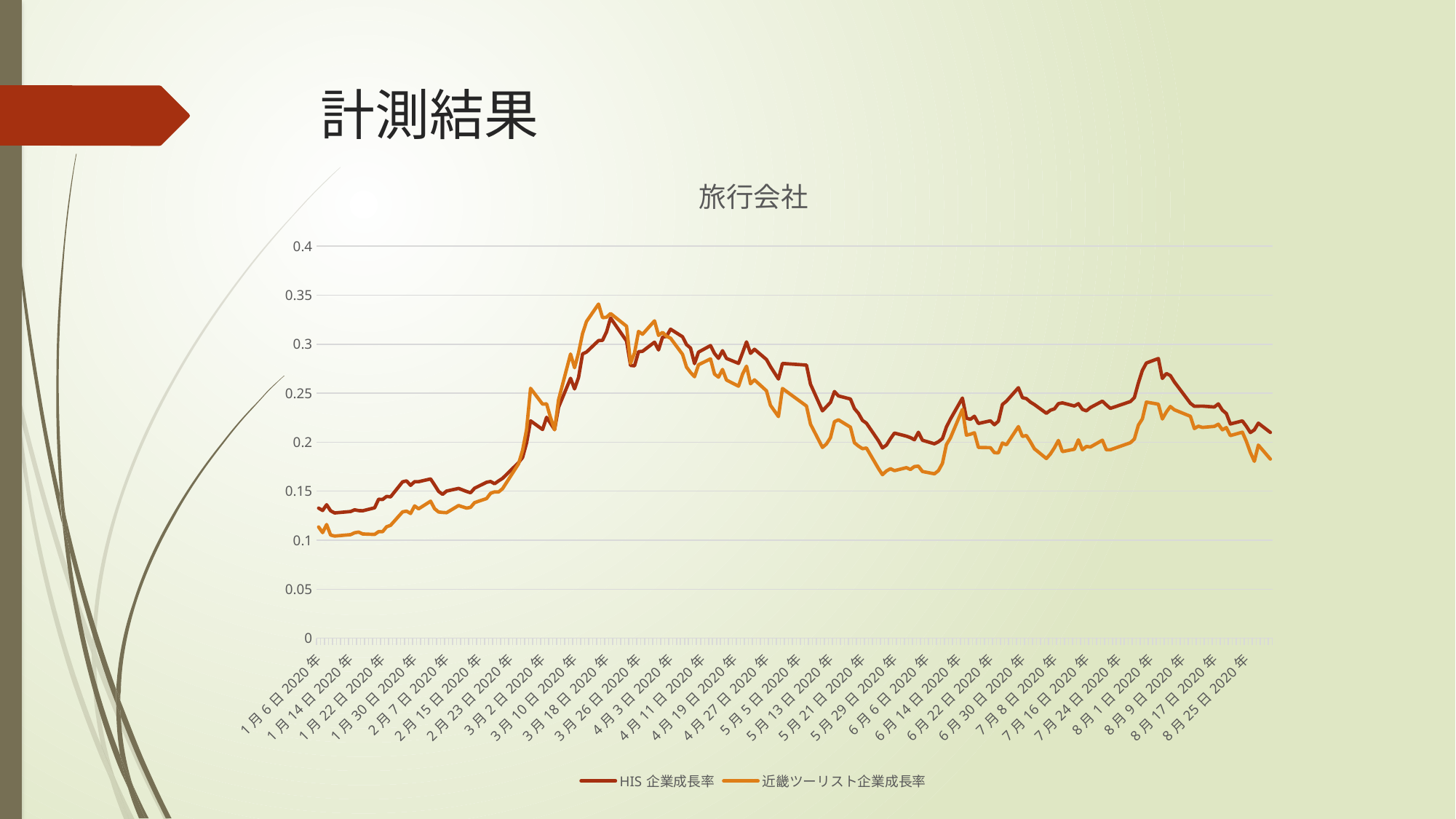
Is the value for 近畿ツーリスト企業成長率 on 6月6日 2020年 greater or less than 0.2? less On 5月21日 2020年, which series has the higher value, HIS 企業成長率 or 近畿ツーリスト企業成長率? HIS 企業成長率 Which series is drawn in orange? 近畿ツーリスト企業成長率 Is the value for 近畿ツーリスト企業成長率 on 1月14日 2020年 greater or less than 0.15? less Is the peak value of 近畿ツーリスト企業成長率 around 3月18日 2020年 greater or less than 0.3? greater What kind of chart is shown on the slide? line chart Do the values for both series rise or fall between 1月6日 2020年 and 3月18日 2020年? rise What is the title of the chart? 旅行会社 Around 3月18日 2020年, which series has the higher value, HIS 企業成長率 or 近畿ツーリスト企業成長率? 近畿ツーリスト企業成長率 How many series does the legend list? 2